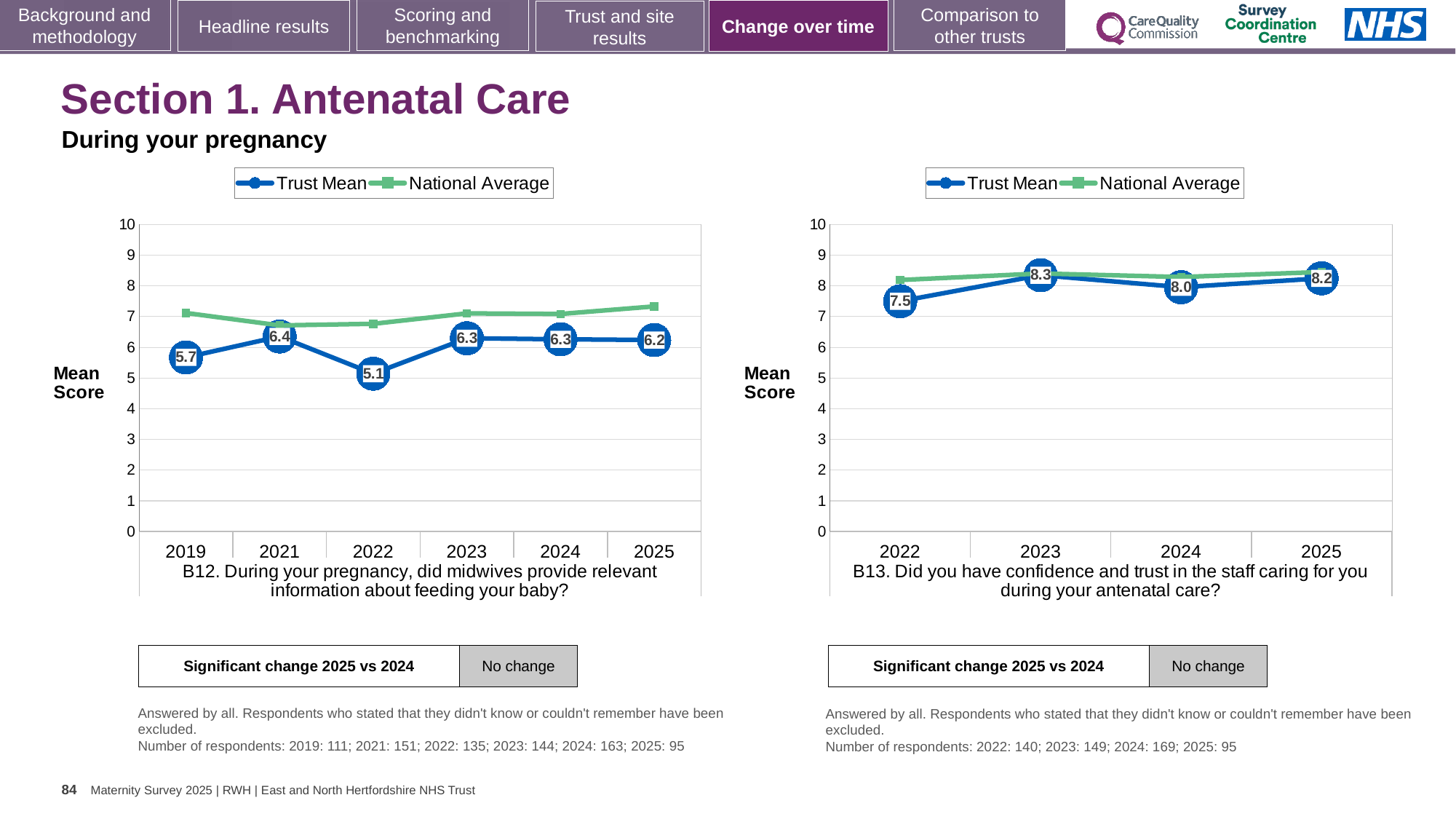
In the right chart (B13), what is the Trust Mean score for 2023? 8.3 How many years are plotted on the x axis of the left chart (B12)? 6 In the right chart (B13), what is the difference between the Trust Mean scores for 2023 and 2022? 0.8 In the left chart (B12), is the National Average value for 2025 greater or less than 7? greater In the left chart (B12), which year has the lowest Trust Mean score? 2022 In the left chart (B12), what is the Trust Mean score for 2022? 5.1 In the right chart (B13), which year has the highest Trust Mean score? 2023 In the left chart (B12), what is the difference between the Trust Mean scores for 2021 and 2022? 1.3 What kind of chart is the right chart (B13)? Line chart How many series does the legend of the right chart (B13) list? 2 In the left chart (B12), which is higher in 2022: the Trust Mean or the National Average? National Average In the right chart (B13), does the Trust Mean rise or fall from 2022 to 2023? Rise